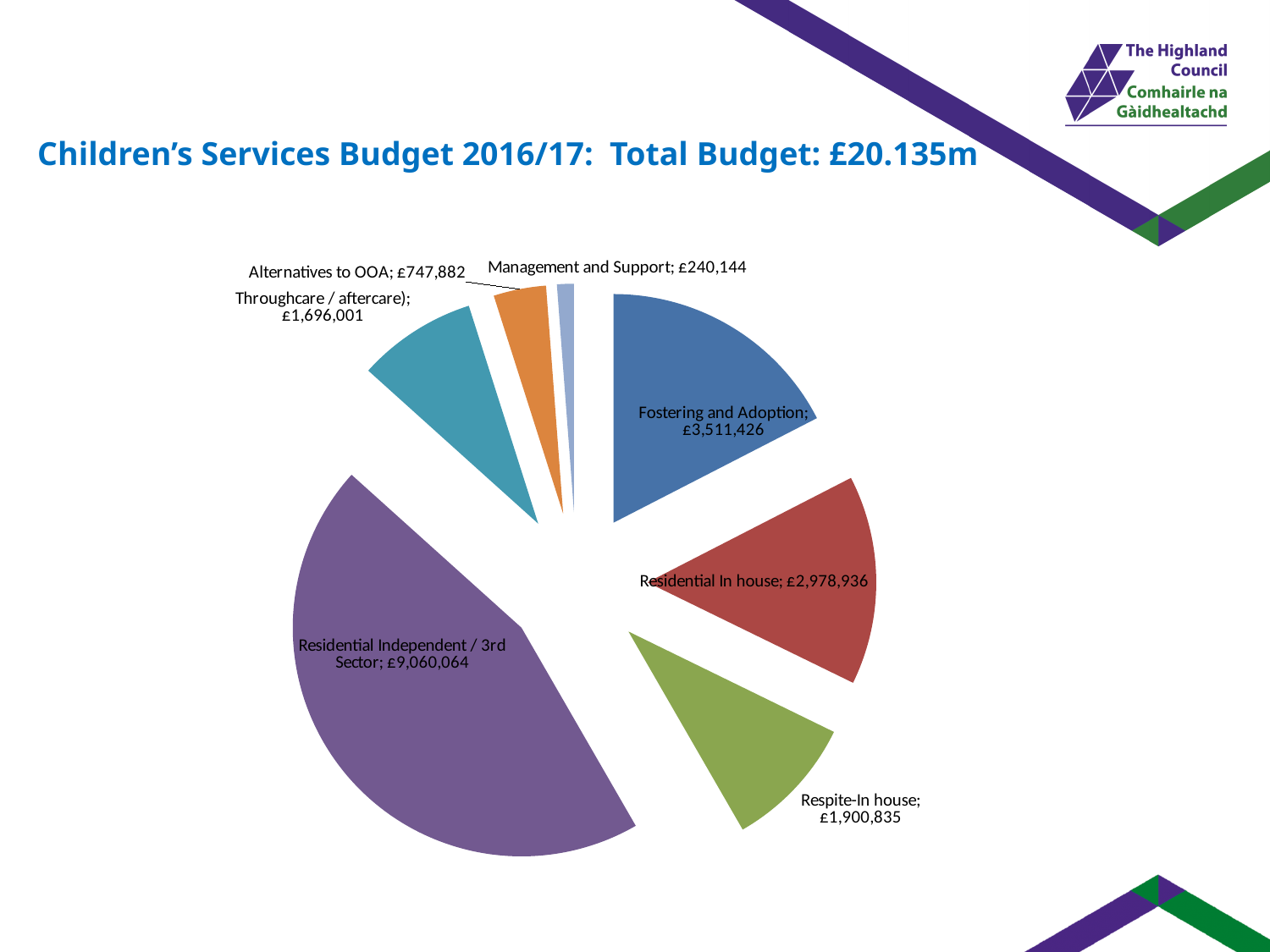
What is the value for Fostering and Adoption? £3,511,426 What is the difference between Fostering and Adoption and Residential In house? £532,490 What kind of chart is shown on the slide? pie chart Which category has the largest slice of the pie? Residential Independent / 3rd Sector How many slices does the pie chart have? 7 What total budget is stated in the slide title? £20.135m What is the value for Respite-In house? £1,900,835 What is the value for Residential Independent / 3rd Sector? £9,060,064 What is the difference between Residential Independent / 3rd Sector and Fostering and Adoption? £5,548,638 Which category has the smallest slice of the pie? Management and Support What is the value for Management and Support? £240,144 Which is larger, Throughcare / aftercare or Alternatives to OOA? Throughcare / aftercare